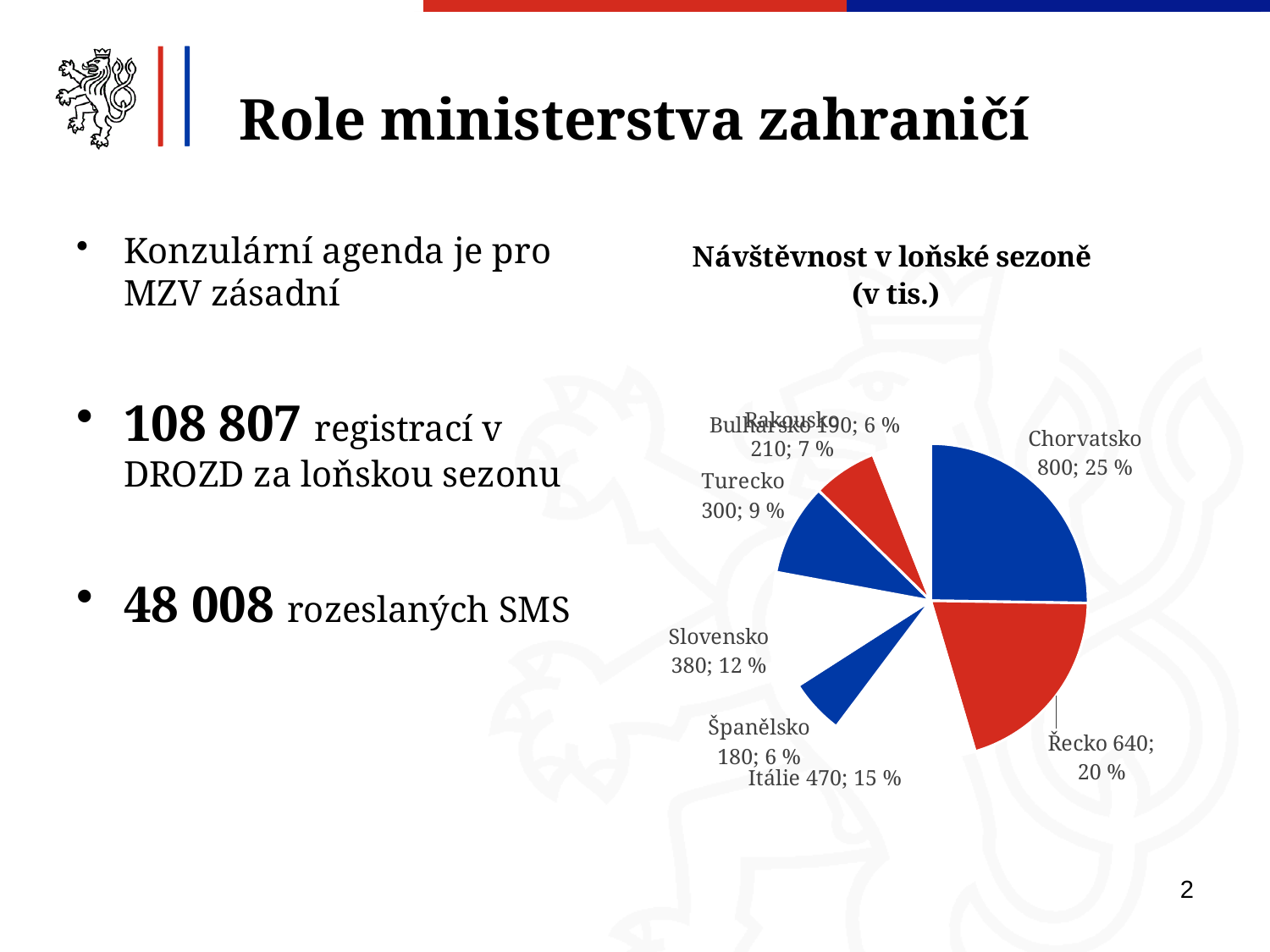
What is the value for Řecko in the pie chart? 640 Which country has the largest slice in the pie chart? Chorvatsko What is the value for Chorvatsko in the pie chart? 800 Which is larger, the value for Slovensko or the value for Turecko? Slovensko Which country has the smallest value in the pie chart? Španělsko What is the value for Turecko in the pie chart? 300 What is the title of the chart? Návštěvnost v loňské sezoně (v tis.) What share of the pie does Itálie represent? 15 % What kind of chart is shown on the slide? pie chart What is the value for Slovensko in the pie chart? 380 What is the difference between the values for Chorvatsko and Řecko? 160